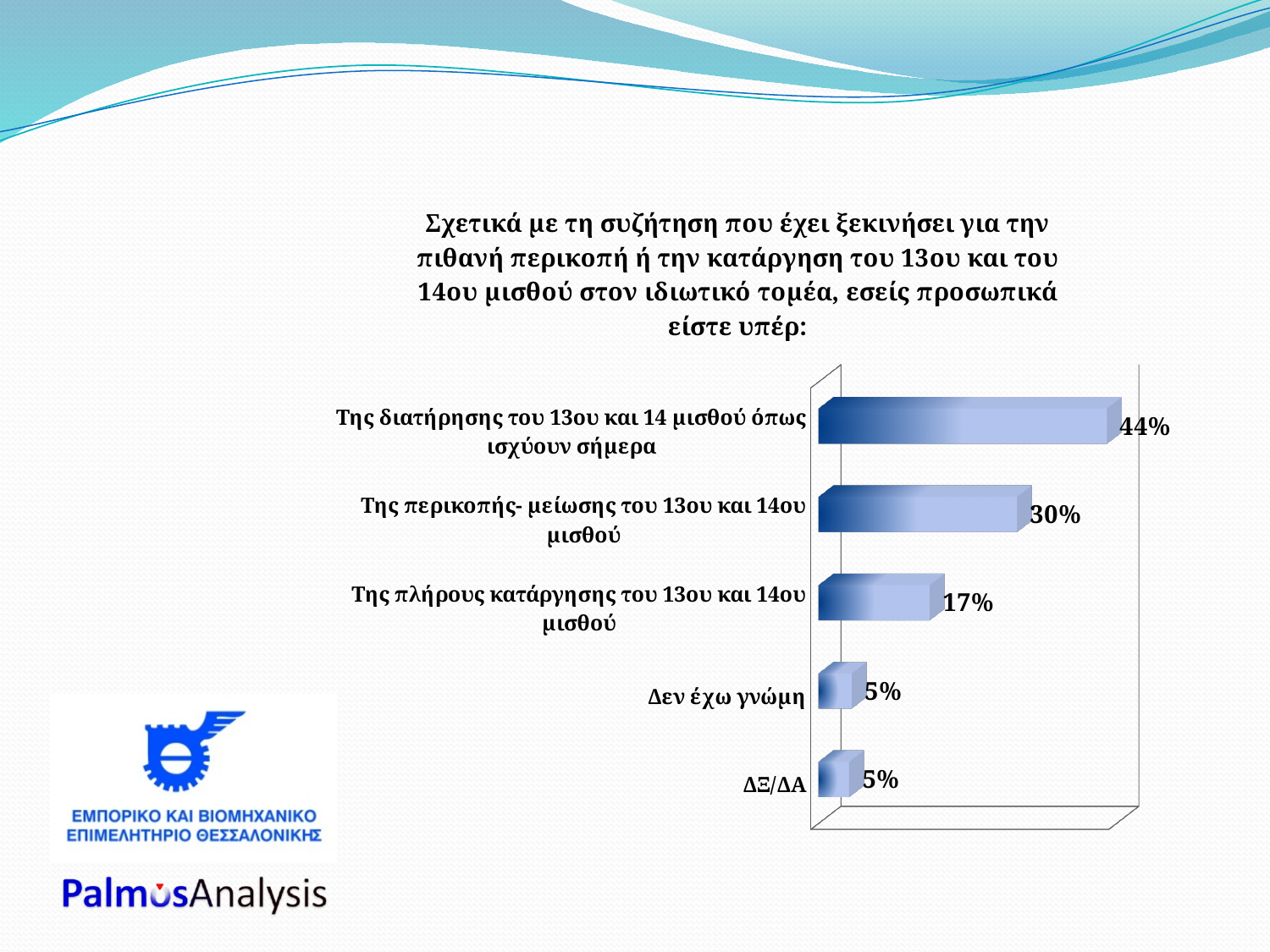
How many categories are shown in the chart? 5 What is the value for 'ΔΞ/ΔΑ'? 5% What kind of chart is shown on the slide? Bar chart Which category has the highest value? Της διατήρησης του 13ου και 14 μισθού όπως ισχύουν σήμερα What is the value for 'Δεν έχω γνώμη'? 5% What is the value for 'Της πλήρους κατάργησης του 13ου και 14ου μισθού'? 17% What percentage of respondents support keeping the 13th and 14th salary as they are today (Της διατήρησης του 13ου και 14 μισθού όπως ισχύουν σήμερα)? 44% What is the difference between the value for keeping the salaries as today (44%) and the value for full abolition (17%)? 27% Which is larger: the value for 'Της περικοπής- μείωσης του 13ου και 14ου μισθού' or the value for 'Της πλήρους κατάργησης του 13ου και 14ου μισθού'? Της περικοπής- μείωσης του 13ου και 14ου μισθού What is the difference between the values for 'Της διατήρησης του 13ου και 14 μισθού όπως ισχύουν σήμερα' and 'Της περικοπής- μείωσης του 13ου και 14ου μισθού'? 14% What is the value for 'Της περικοπής- μείωσης του 13ου και 14ου μισθού'? 30% Do the bar values increase or decrease from the top category to the bottom category? Decrease